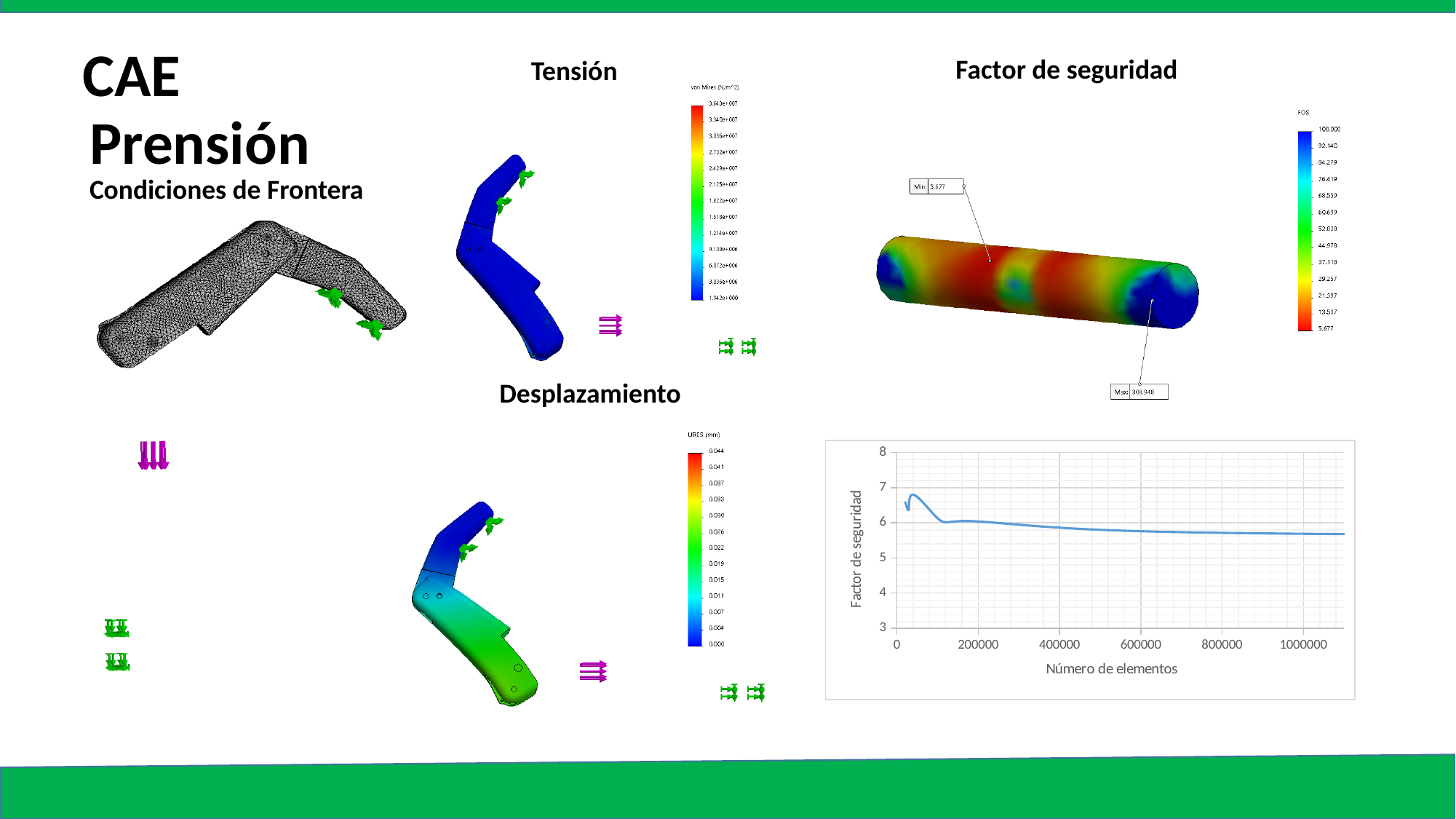
In the bottom-right chart, is the factor de seguridad at 1000000 elementos greater or less than 5? greater In the bottom-right chart, does the factor de seguridad rise or fall as the número de elementos increases? fall In the bottom-right chart, is the highest value reached by the line greater or less than 7? less In the bottom-right chart, is the factor de seguridad at 600000 elementos greater or less than 6? less What kind of chart is shown at the bottom right of the slide? line chart In the bottom-right chart, what is the label of the x axis? Número de elementos In the bottom-right chart, what is the label of the y axis? Factor de seguridad